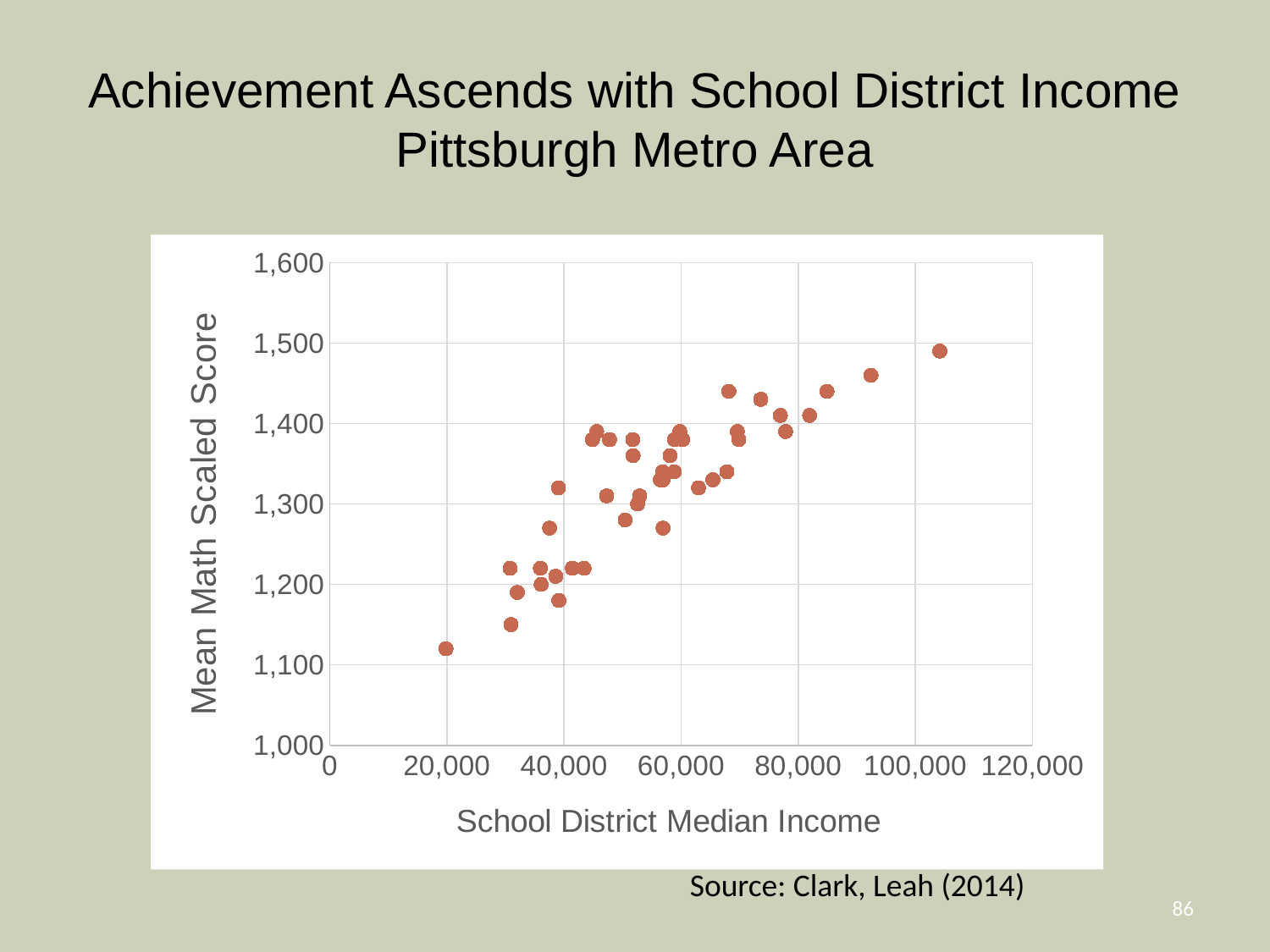
What is the label of the y axis? Mean Math Scaled Score Is the mean math scaled score of the point with the highest median income greater or less than 1,400? greater Is the mean math scaled score of the point with the lowest median income greater or less than 1,200? less Is the lowest mean math scaled score plotted greater or less than 1,100? greater Do the mean math scaled scores generally rise or fall as school district median income increases? rise Which has the higher mean math scaled score: the point with the highest median income or the point with the lowest median income? the point with the highest median income What kind of chart is shown on the slide? scatter plot What is the label of the x axis? School District Median Income